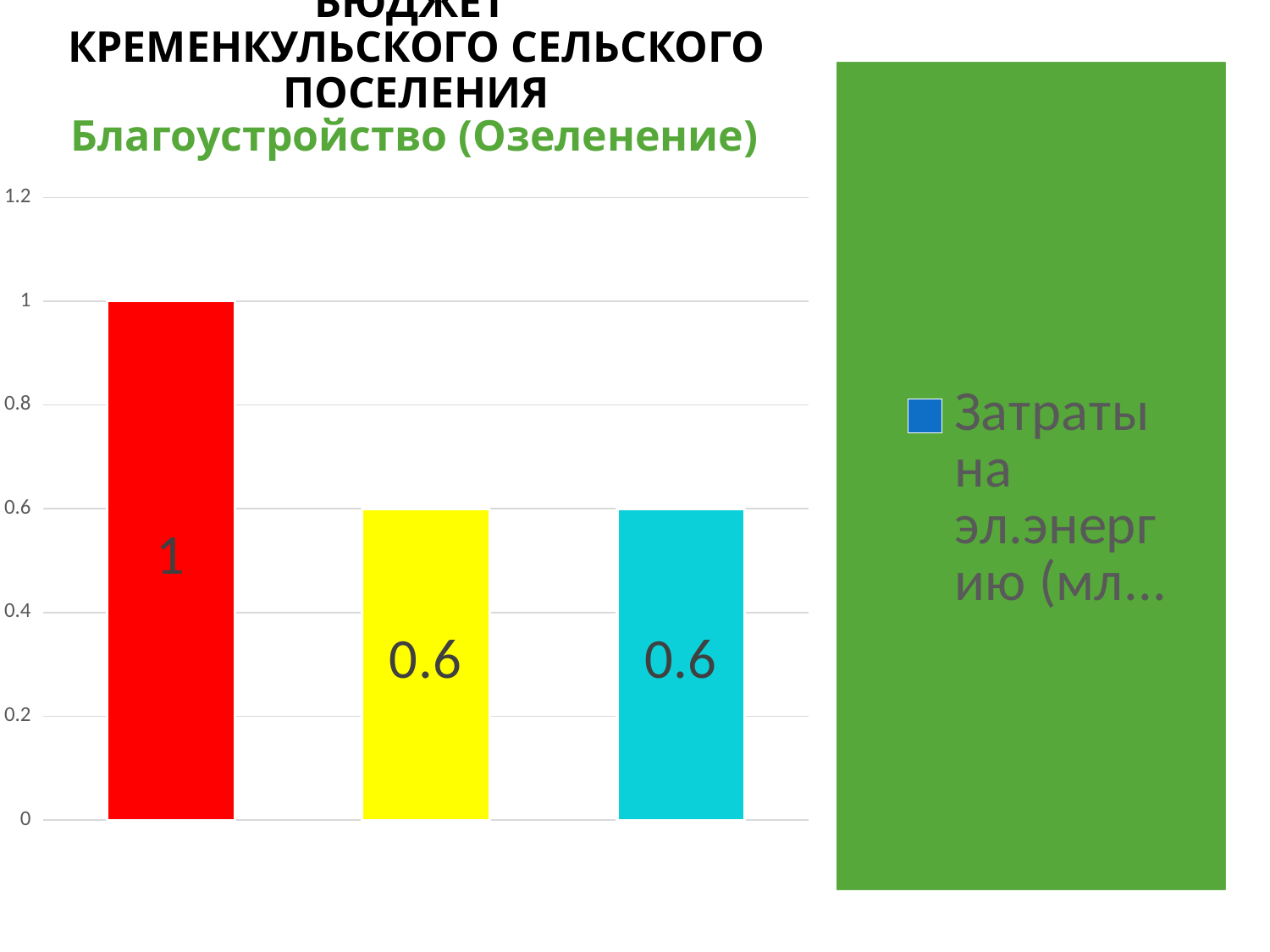
What is the value shown on the cyan (light blue) bar? 0.6 What kind of chart is shown on the slide? Bar chart How many series does the legend list? 1 How many bars are plotted in the chart? 3 What is the highest value shown on the vertical axis? 1.2 Which bar has the highest value? The red bar What is the value shown on the yellow bar? 0.6 Is the value of the yellow bar greater or less than 0.8? less What is the value shown on the red bar? 1 What is the difference between the value of the red bar and the value of the yellow bar? 0.4 Which is larger, the value of the red bar or the value of the cyan bar? The red bar What is the green subtitle of the chart on the slide? Благоустройство (Озеленение)